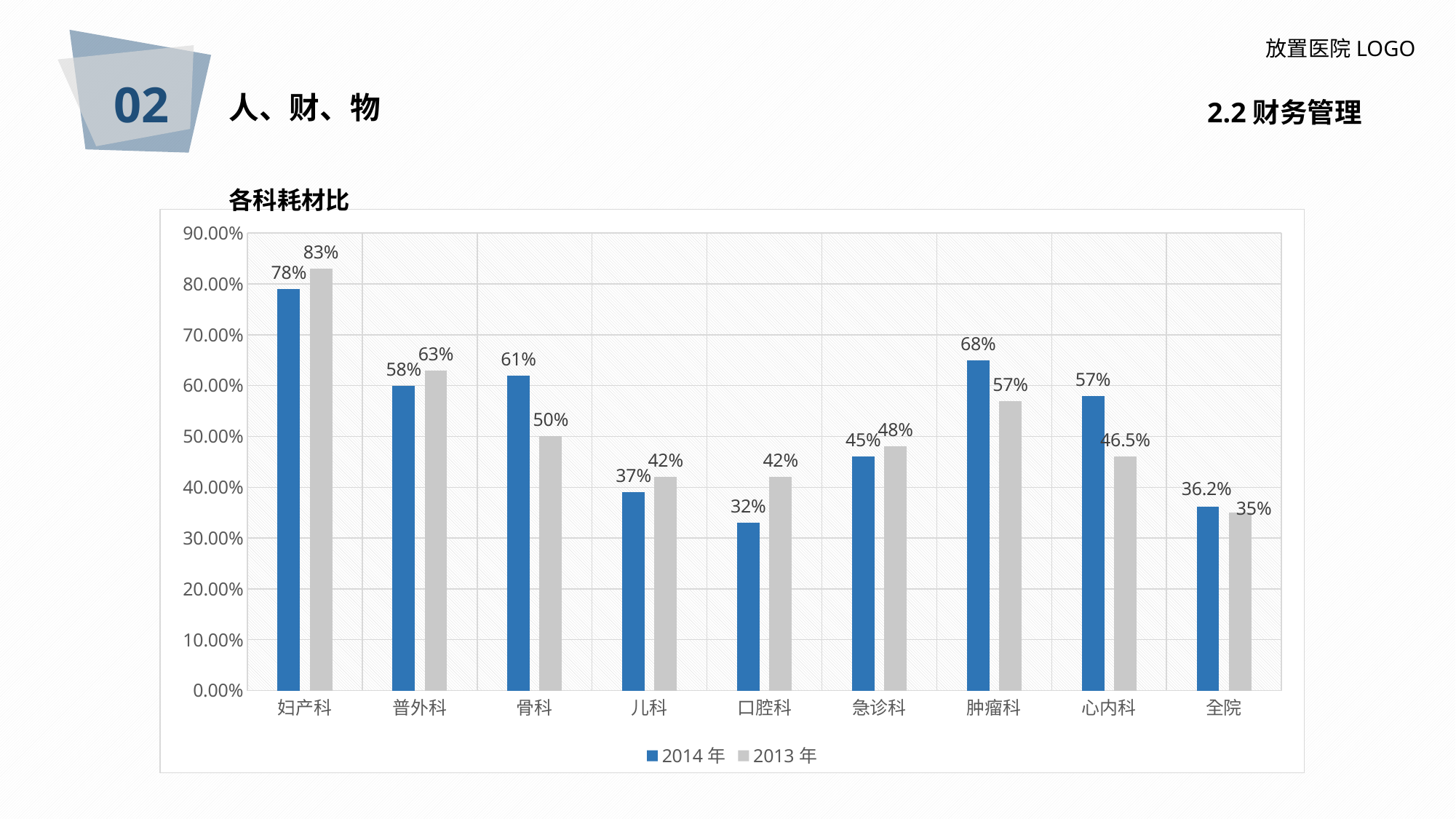
What is the 2014 年 value for 骨科? 61% What is the difference between the 2014 年 values for 妇产科 and 普外科? 20% What is the 2014 年 value for 全院? 36.2% Which is larger for 肿瘤科, the 2014 年 value or the 2013 年 value? 2014 年 How many series does the legend list? 2 What is the 2013 年 value for 心内科? 46.5% What type of chart is shown on the slide? bar chart Which category has the lowest 2014 年 value? 口腔科 How many categories are shown on the x axis? 9 What is the difference between the 2013 年 and 2014 年 values for 口腔科? 10% Which category has the highest 2013 年 value? 妇产科 What is the title of the chart? 各科耗材比